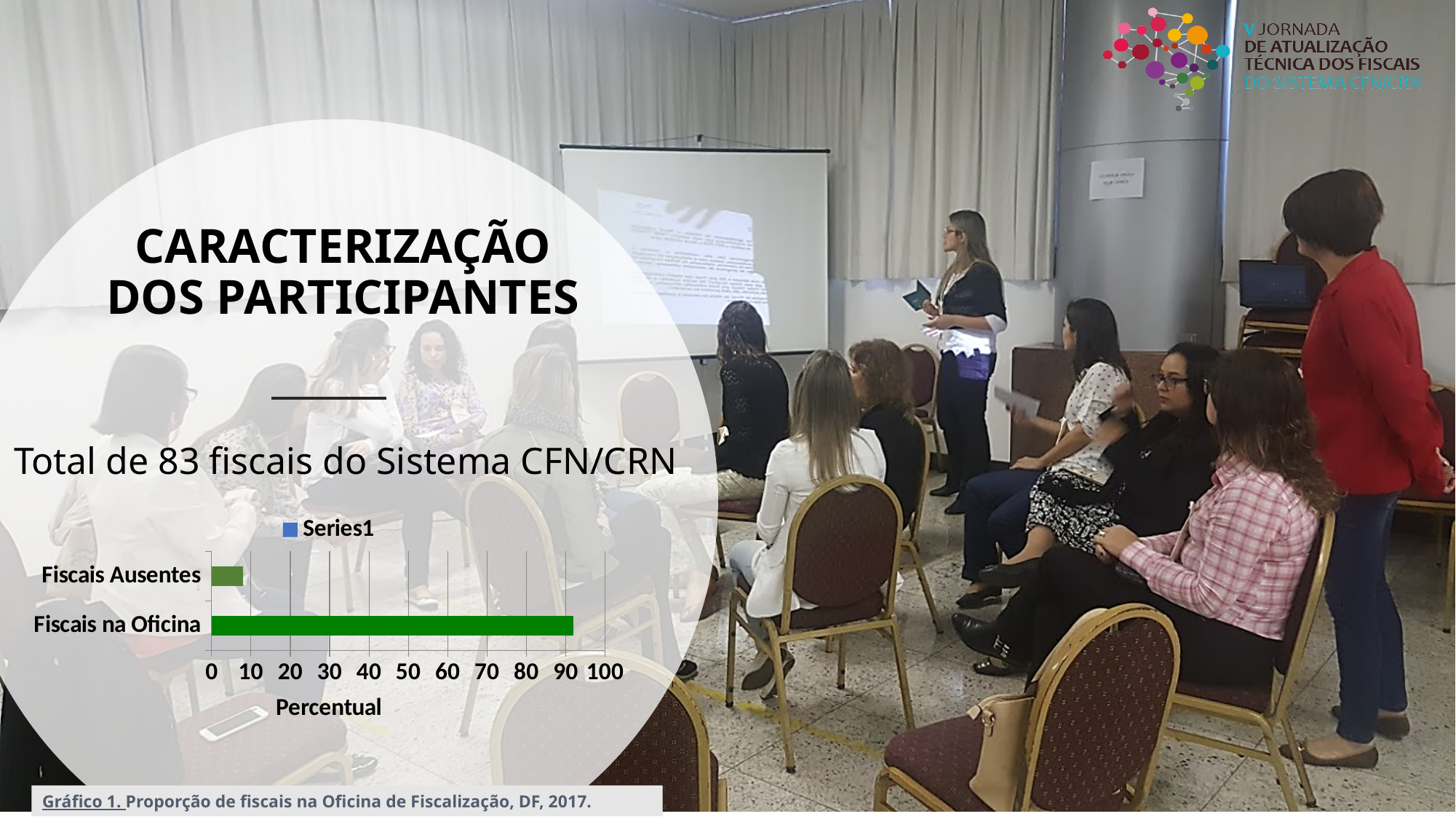
Which category has the highest value in the chart? Fiscais na Oficina Is the value for Fiscais na Oficina greater or less than 50? greater What is the title of the horizontal axis of the chart? Percentual Is the value for Fiscais na Oficina greater or less than 80? greater Which is larger, the value for Fiscais na Oficina or the value for Fiscais Ausentes? Fiscais na Oficina What kind of chart is shown on the slide? bar chart How many series does the chart legend list? 1 Which category has the lowest value in the chart? Fiscais Ausentes What is the name of the series shown in the chart legend? Series1 How many categories are plotted in the chart? 2 Is the value for Fiscais Ausentes greater or less than 20? less